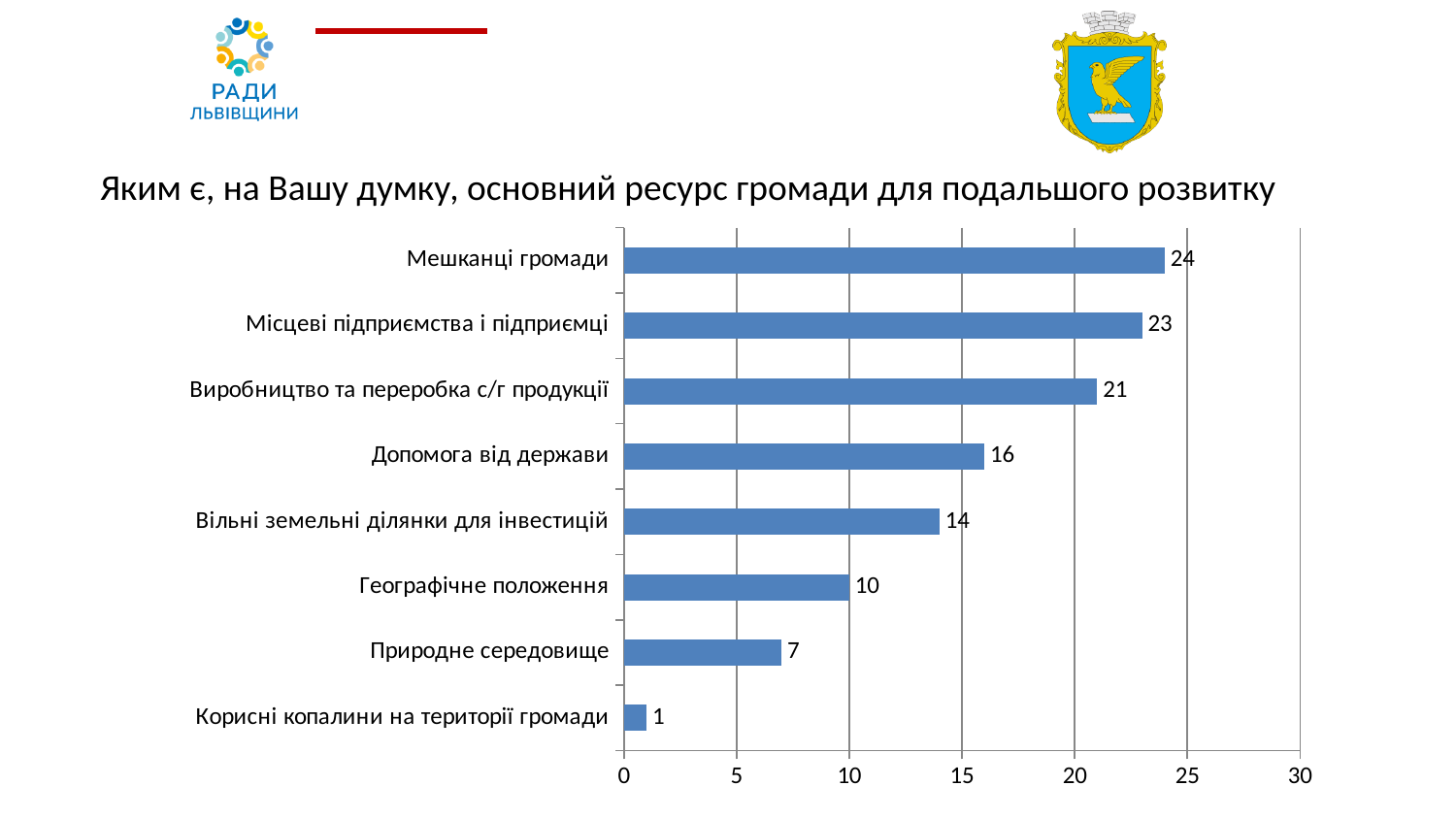
What is the value for Допомога від держави? 16 Which category has the highest value? Мешканці громади Which category has the lowest value? Корисні копалини на території громади Is the value for Виробництво та переробка с/г продукції greater or less than 20? greater What is the difference between the values for Мешканці громади and Природне середовище? 17 Which is larger: the value for Вільні земельні ділянки для інвестицій or the value for Географічне положення? Вільні земельні ділянки для інвестицій What is the value for Географічне положення? 10 What is the difference between the values for Місцеві підприємства і підприємці and Допомога від держави? 7 How many categories are shown in the chart? 8 What is the value for Мешканці громади? 24 What is the title of the chart? Яким є, на Вашу думку, основний ресурс громади для подальшого розвитку What kind of chart is shown on the slide? bar chart